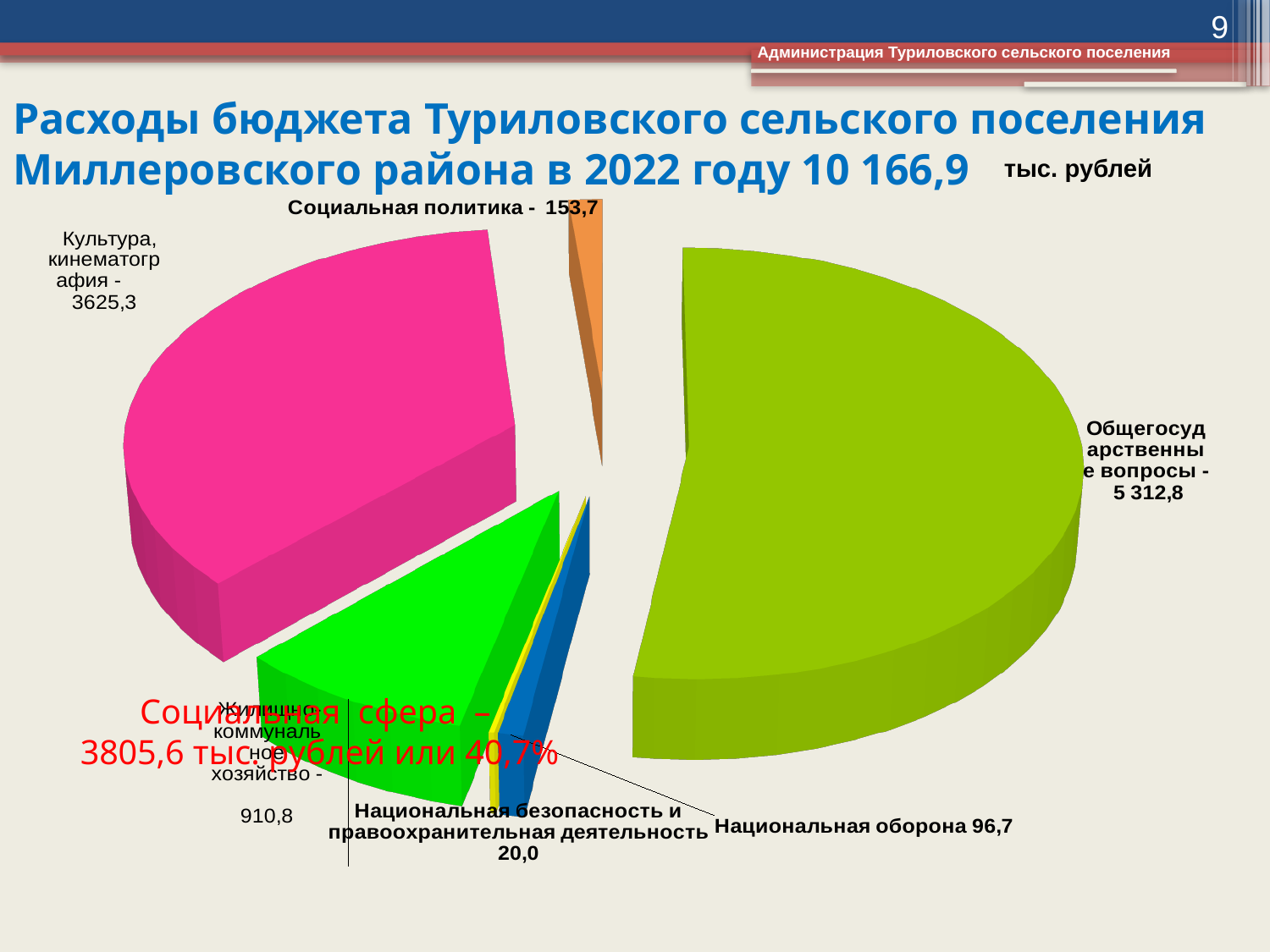
How many slices does the pie chart have? 6 What is the value for Национальная оборона? 96,7 What is the value for Жилищно-коммунальное хозяйство? 910,8 Which is larger: Социальная политика or Национальная оборона? Социальная политика What is the difference between the values for Общегосударственные вопросы and Культура, кинематография? 1 687,5 What is the value for Культура, кинематография? 3625,3 What is the value for Социальная политика? 153,7 What is the value for Национальная безопасность и правоохранительная деятельность? 20,0 Which category has the largest slice of the pie? Общегосударственные вопросы What is the value for Общегосударственные вопросы? 5 312,8 What kind of chart is shown on the slide? Pie chart Which category has the smallest slice of the pie? Национальная безопасность и правоохранительная деятельность